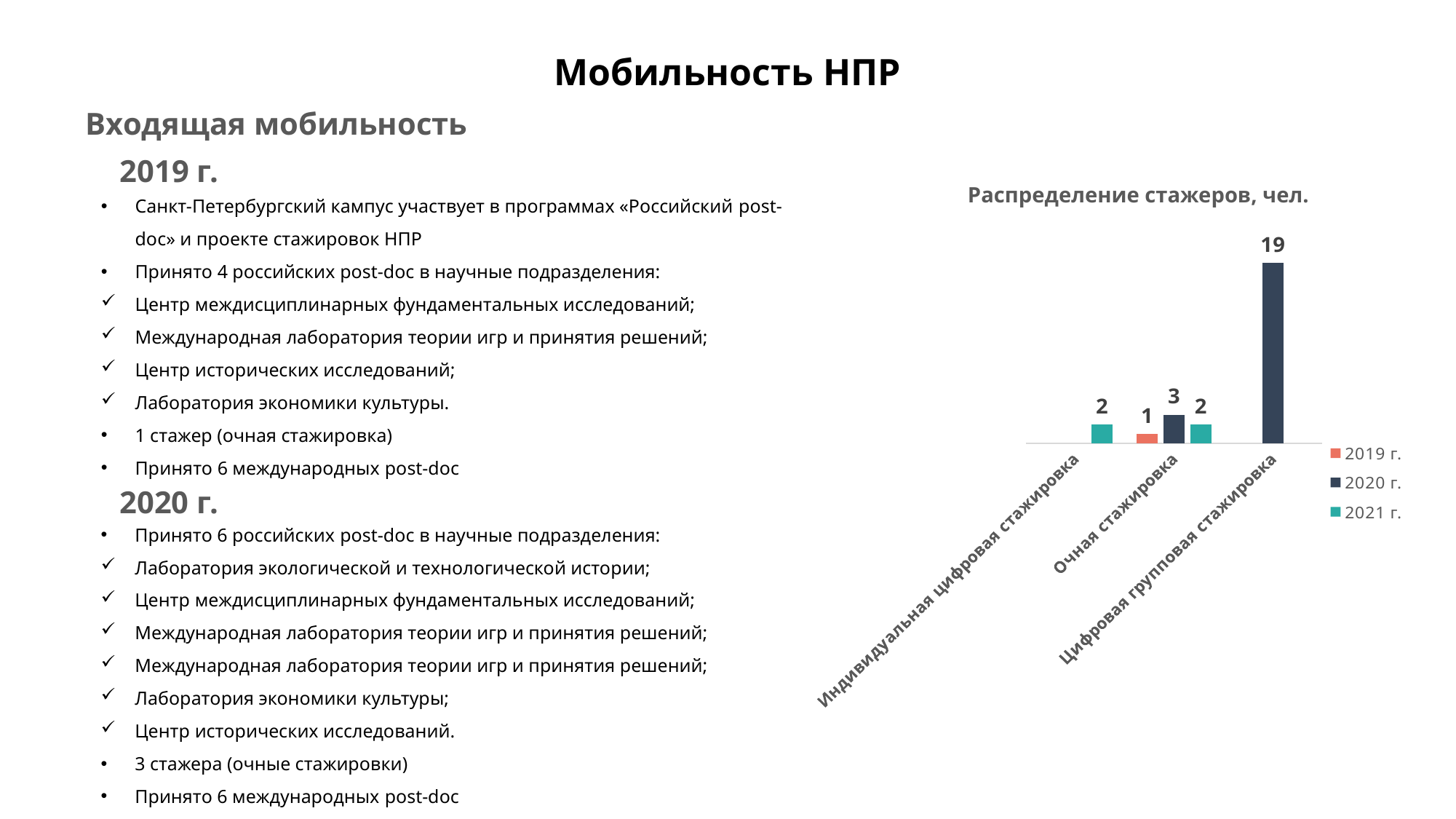
What is the value for "2020 г." in the category "Очная стажировка"? 3 Which series has the lowest value in the category "Очная стажировка"? 2019 г. How many series does the legend of the chart "Распределение стажеров, чел." list? 3 How many categories are shown on the x axis of the chart "Распределение стажеров, чел."? 3 In the category "Очная стажировка", which is larger: the value for "2020 г." or for "2021 г."? 2020 г. Which category has the highest bar in the chart "Распределение стажеров, чел."? Цифровая групповая стажировка What type of chart is shown under the title "Распределение стажеров, чел."? bar chart What is the difference between the "2020 г." values for "Цифровая групповая стажировка" and "Очная стажировка"? 16 What is the value for "2020 г." in the category "Цифровая групповая стажировка"? 19 What is the value for "2019 г." in the category "Очная стажировка"? 1 What is the value for "2021 г." in the category "Индивидуальная цифровая стажировка"? 2 What is the title of the chart on the right side of the slide? Распределение стажеров, чел.